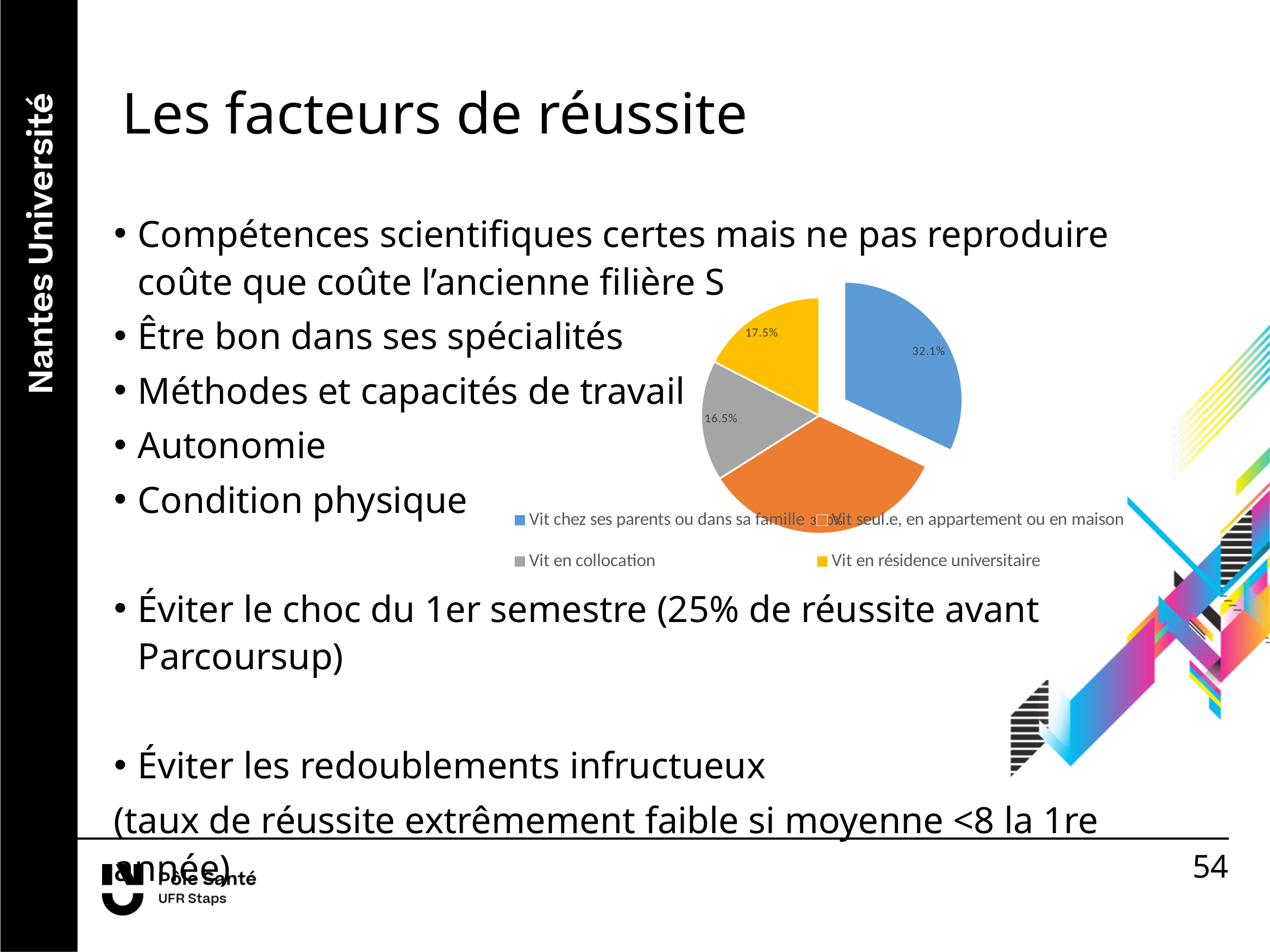
What percentage is shown for 'Vit en collocation' in the pie chart? 16.5% What colour represents 'Vit seul.e, en appartement ou en maison' in the pie chart? Orange What is the difference between the 'Vit chez ses parents ou dans sa famille' and 'Vit en collocation' shares in the pie chart? 15.6% What is the difference between the 'Vit en résidence universitaire' and 'Vit en collocation' shares in the pie chart? 1.0% Which is larger in the pie chart: 'Vit chez ses parents ou dans sa famille' or 'Vit en résidence universitaire'? Vit chez ses parents ou dans sa famille What is the difference between the 'Vit chez ses parents ou dans sa famille' and 'Vit en résidence universitaire' shares in the pie chart? 14.6% What percentage is shown for 'Vit en résidence universitaire' in the pie chart? 17.5% How many slices does the pie chart have? 4 Which is larger in the pie chart: 'Vit en résidence universitaire' or 'Vit en collocation'? Vit en résidence universitaire What share of the pie chart is labelled for 'Vit chez ses parents ou dans sa famille'? 32.1% Which category has the smallest slice in the pie chart? Vit en collocation What type of chart is shown on the slide? Pie chart